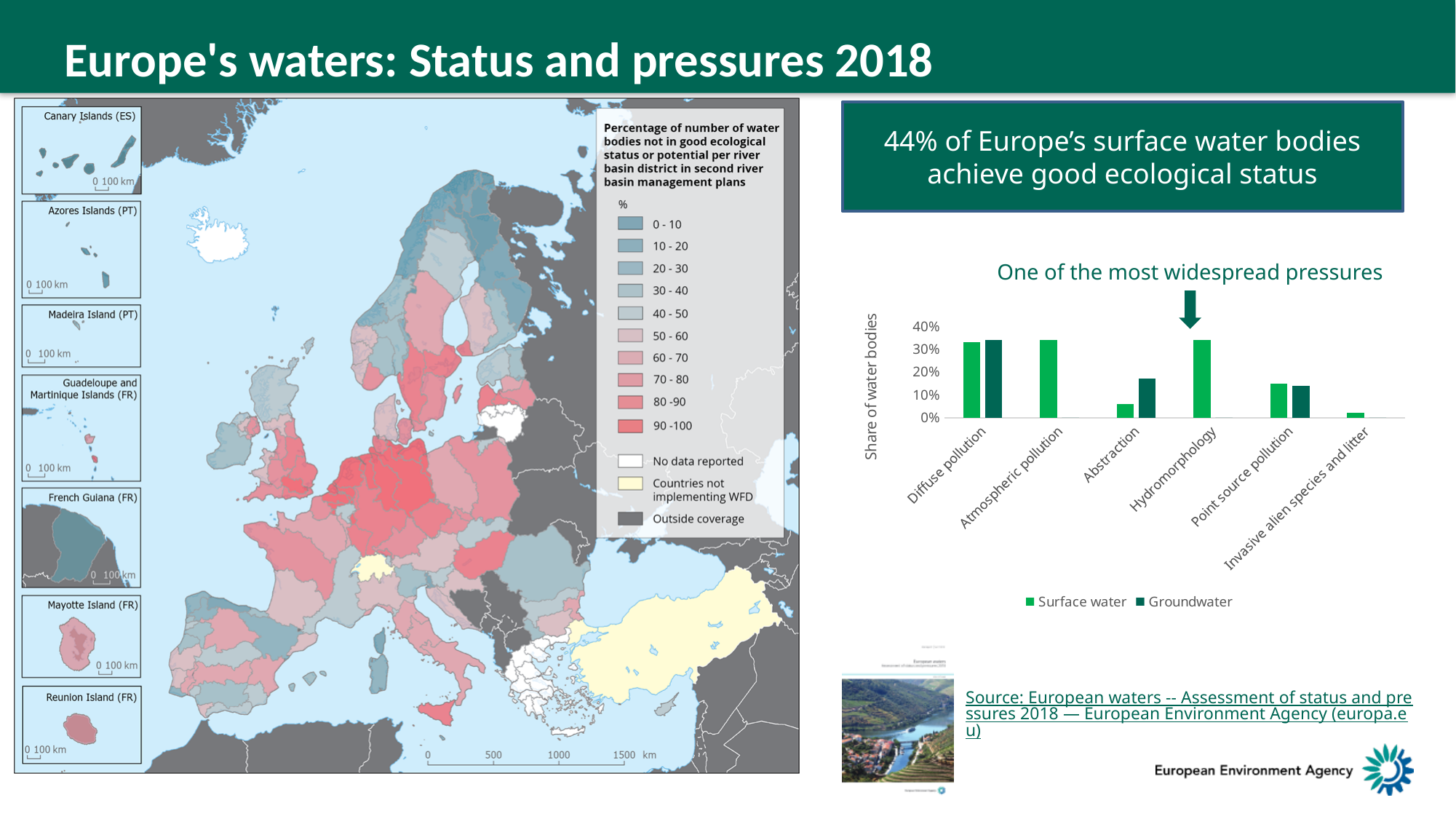
In the bar chart, which has the larger Surface water value: Diffuse pollution or Abstraction? Diffuse pollution In the bar chart, is the Surface water value for Abstraction greater or less than 10%? less How many series does the legend of the bar chart list? 2 In the bar chart, is the Surface water value for Point source pollution greater or less than 20%? less In the bar chart, is the Surface water value for Hydromorphology greater or less than 30%? greater In the bar chart, which category has the lowest Surface water value? Invasive alien species and litter In the bar chart, which is larger for Abstraction: the Surface water value or the Groundwater value? Groundwater What is the label on the y axis of the bar chart? Share of water bodies What kind of chart is shown on the right side of the slide? bar chart Which category in the bar chart is marked with the arrow labelled 'One of the most widespread pressures'? Hydromorphology How many pressure categories are shown on the x axis of the bar chart? 6